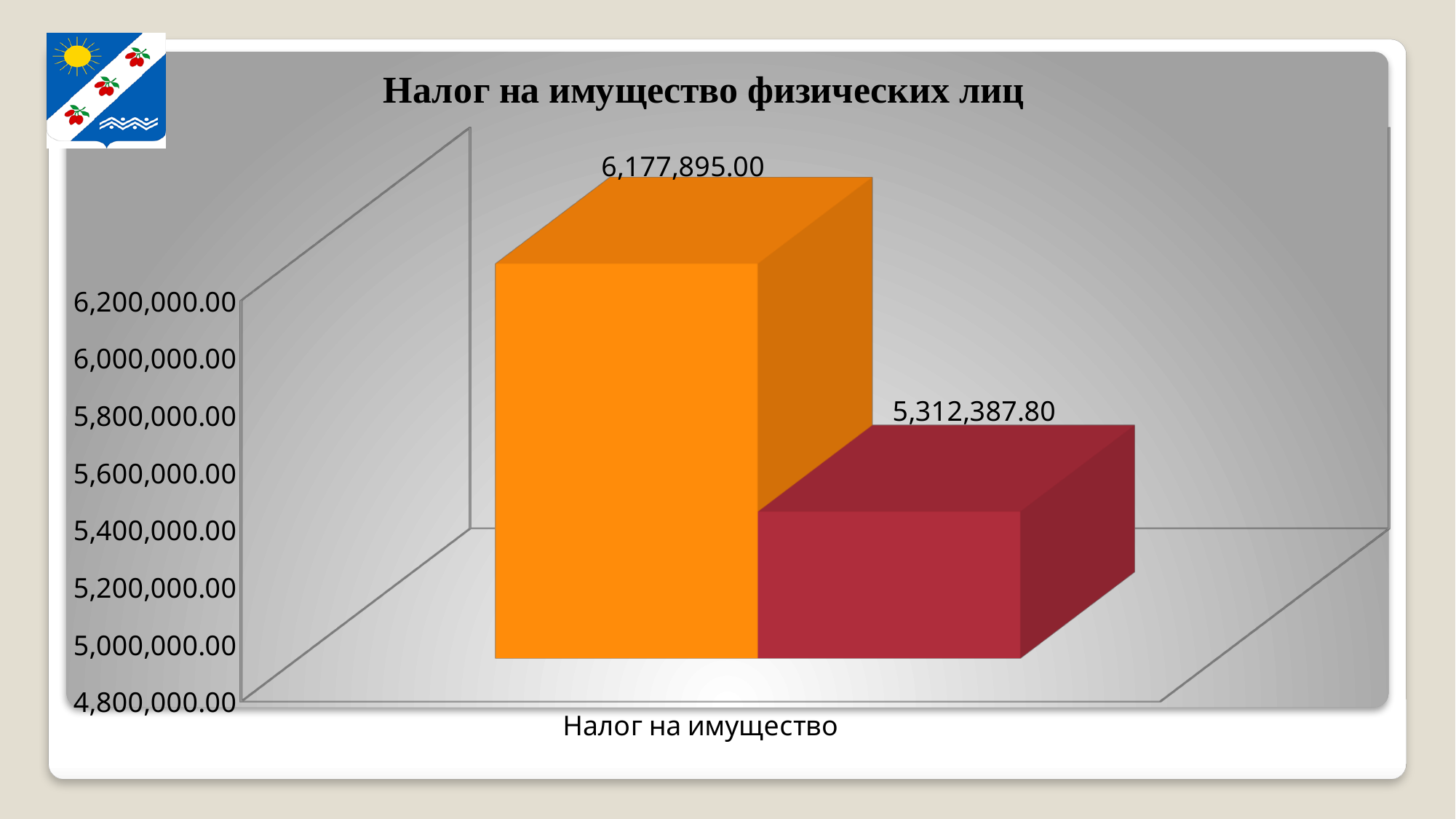
What is the difference between the orange bar's value and the red bar's value? 865,507.20 What is the category label shown on the x axis? Налог на имущество What kind of chart is shown on the slide? bar chart Which bar has the lowest value? the red bar Which bar is taller, the orange one or the red one? the orange one How many categories are shown on the x axis? 1 How many bars are plotted on the chart? 2 Is the value of the orange bar greater or less than 6,000,000.00? greater Is the value of the red bar greater or less than 5,400,000.00? less What is the title of the chart? Налог на имущество физических лиц What value is shown on the red bar? 5,312,387.80 What value is shown on the orange bar? 6,177,895.00